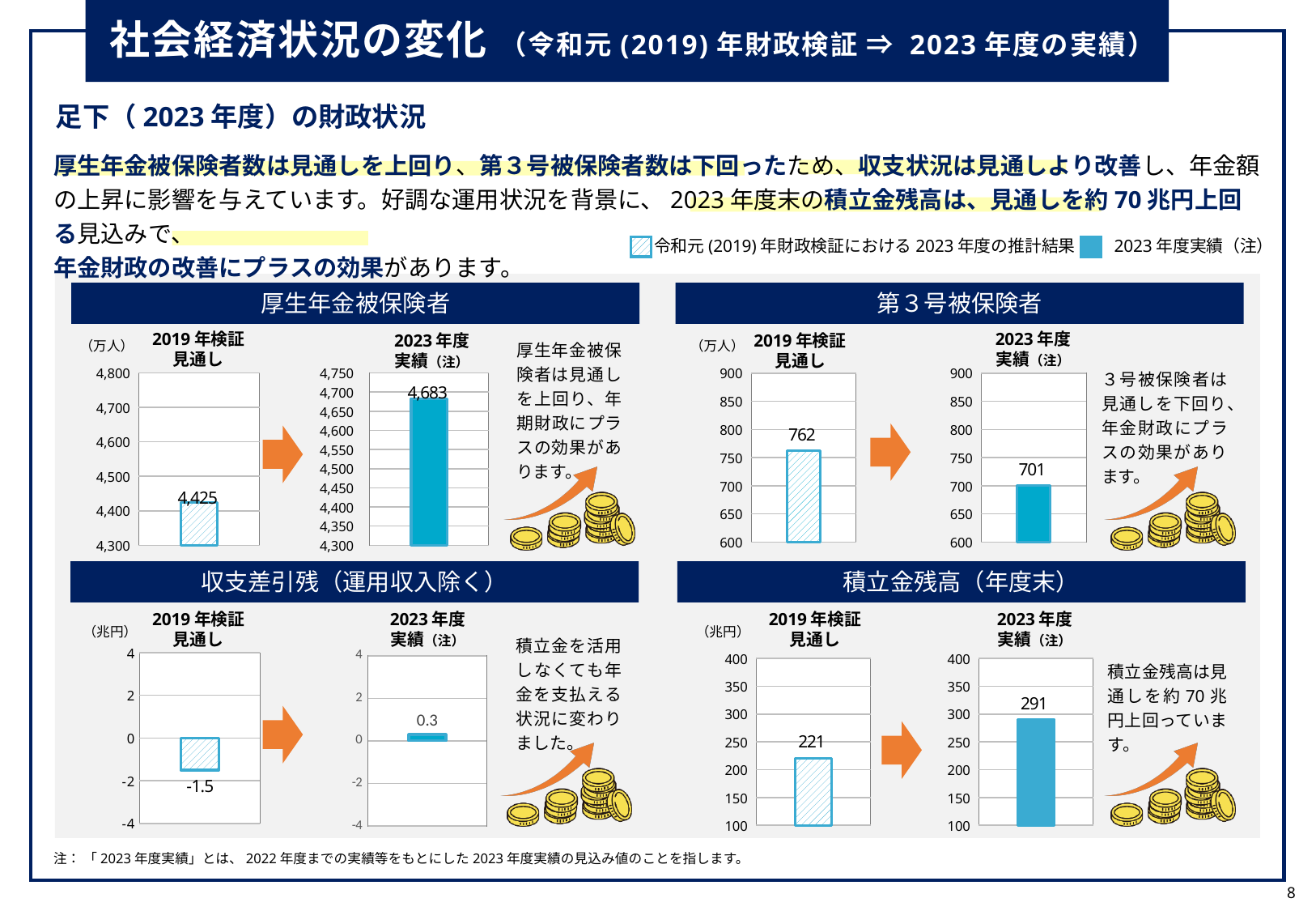
In the 収支差引残（運用収入除く） chart, what is the value shown for the 2019年検証見通し bar? -1.5 In the 厚生年金被保険者 chart, what is the difference between the 2023年度実績 value and the 2019年検証見通し value? 258 What kind of chart is used in the 積立金残高（年度末） panel? Bar chart In the 第3号被保険者 chart, what is the value shown for the 2023年度実績 bar? 701 In the 第3号被保険者 chart, which is larger, the 2019年検証見通し value or the 2023年度実績 value? 2019年検証見通し In the 積立金残高（年度末） chart, what is the value shown for the 2023年度実績 bar? 291 In the 第3号被保険者 chart, what is the value shown for the 2019年検証見通し bar? 762 In the 収支差引残（運用収入除く） chart, what is the value shown for the 2023年度実績 bar? 0.3 In the 積立金残高（年度末） chart, what is the value shown for the 2019年検証見通し bar? 221 In the 積立金残高（年度末） chart, what is the difference between the 2023年度実績 value and the 2019年検証見通し value? 70 In the 厚生年金被保険者 chart, what is the value shown for the 2023年度実績 bar? 4,683 In the 厚生年金被保険者 chart, what is the value shown for the 2019年検証見通し bar? 4,425